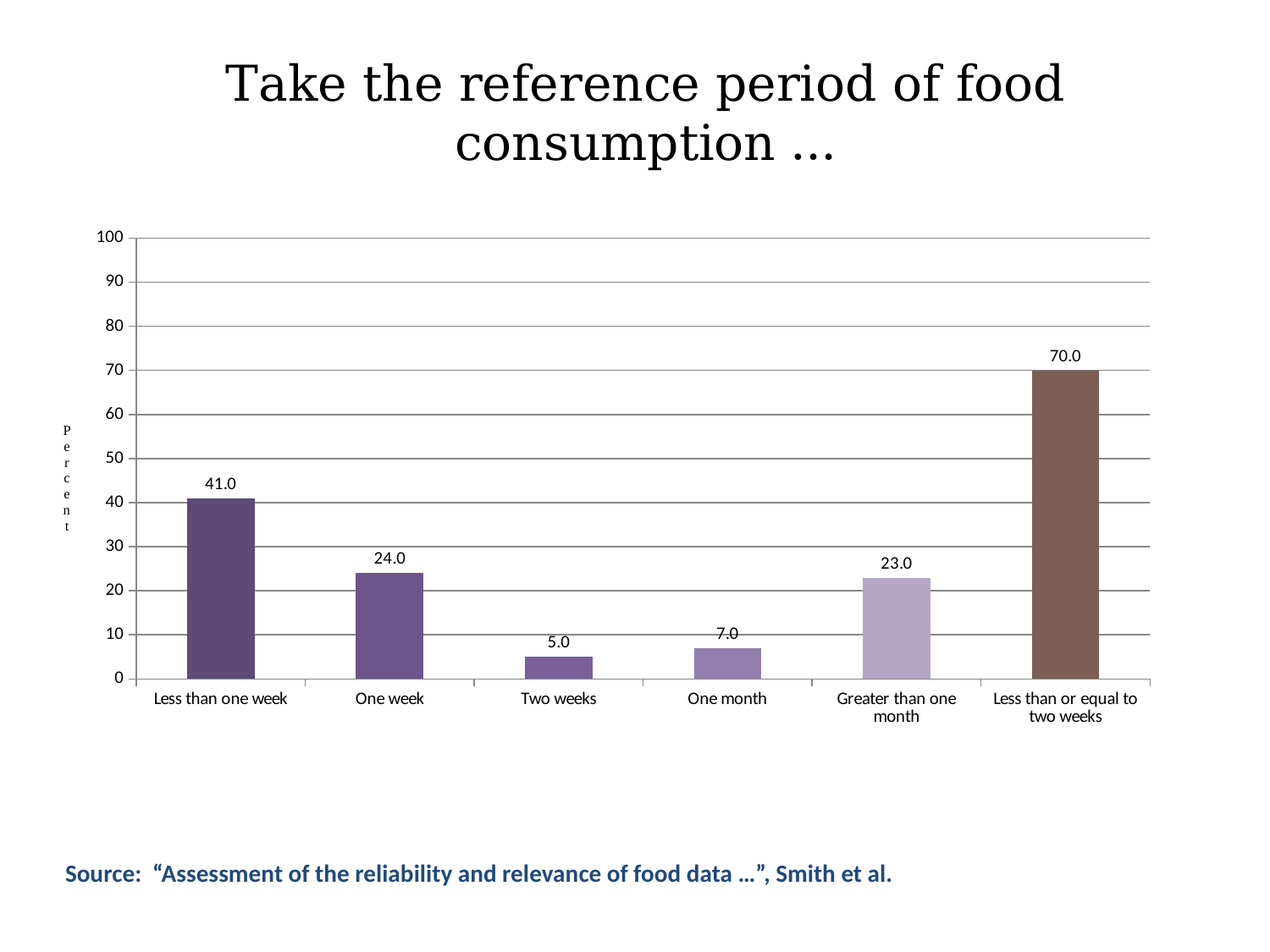
What is the value for "One week"? 24.0 Which category has the highest value? Less than or equal to two weeks Which is larger, the value for "One week" or the value for "One month"? One week Is the value for "Less than one week" greater or less than 50? less What is the difference between the values for "Less than or equal to two weeks" and "Less than one week"? 29.0 Which category has the lowest value? Two weeks What is the value for "Two weeks"? 5.0 What is the value for "Less than one week"? 41.0 How many categories are shown on the x axis? 6 What is the label of the vertical axis? Percent What kind of chart is shown on the slide? Bar chart What is the value for "Greater than one month"? 23.0